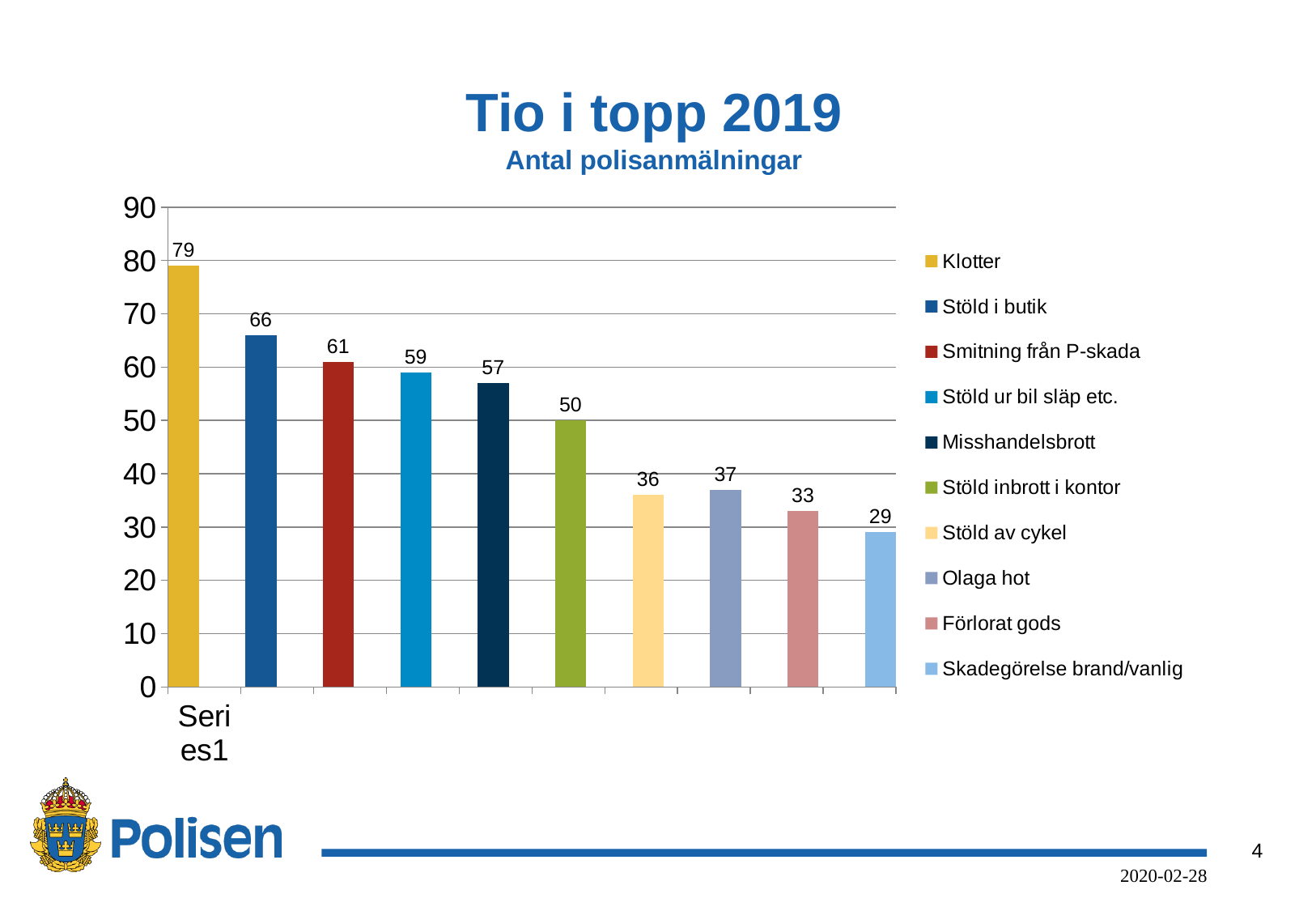
What is the number of police reports for Klotter? 79 Which is larger, the value for Smitning från P-skada or the value for Stöld ur bil släp etc.? Smitning från P-skada What is the subtitle shown under the chart title 'Tio i topp 2019'? Antal polisanmälningar What is the difference between the values for Klotter and Stöld i butik? 13 What is the value shown for Skadegörelse brand/vanlig? 29 What kind of chart is shown on the slide? Bar chart Which legend entry has the lowest value? Skadegörelse brand/vanlig What is the value shown for Stöld i butik? 66 Which legend entry has the highest value? Klotter What is the value shown for Misshandelsbrott? 57 How many series does the legend list? 10 What is the difference between the values for Stöld inbrott i kontor and Förlorat gods? 17